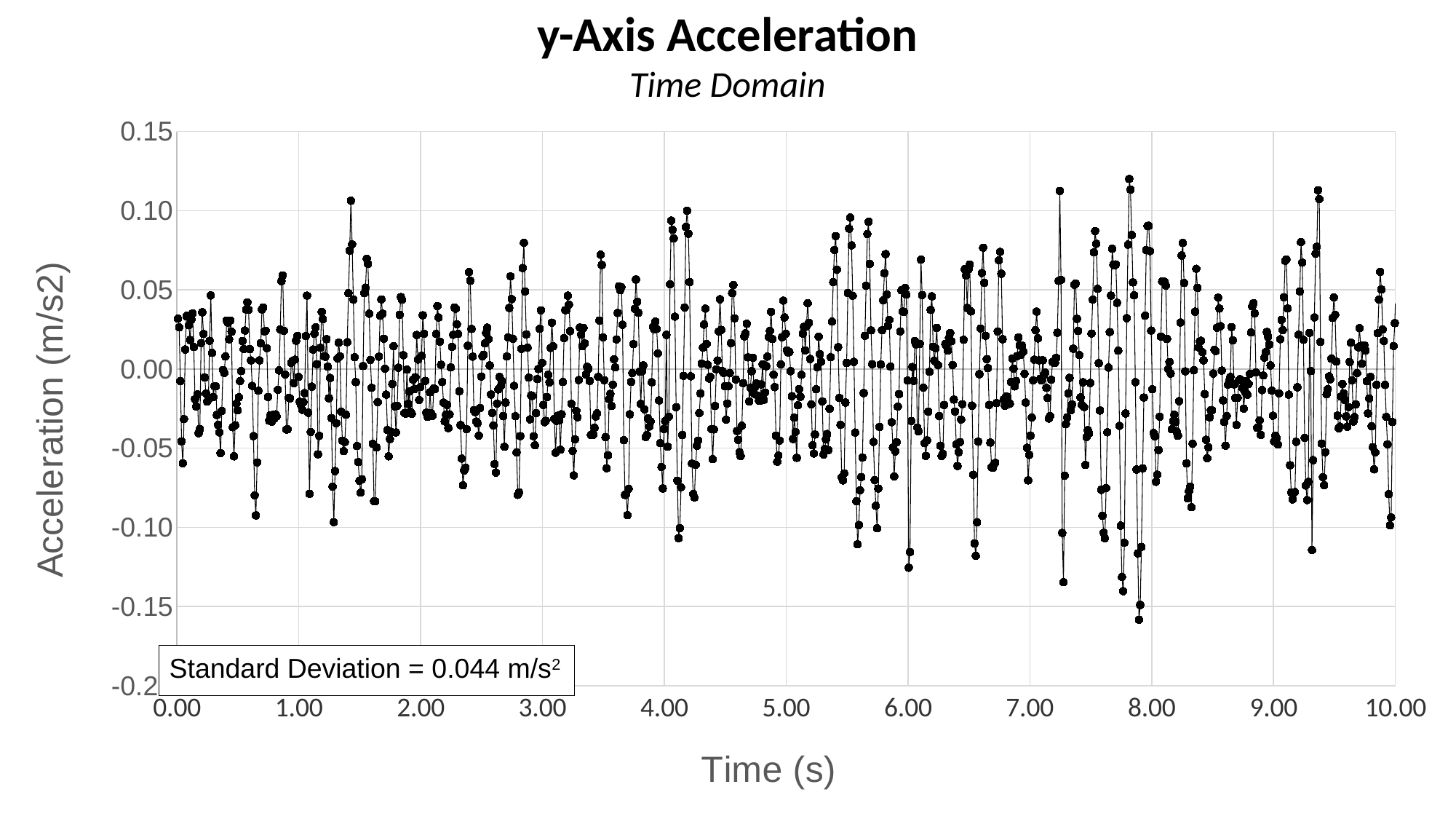
What subtitle appears under the chart title? Time Domain What is the largest time value shown on the x axis? 10.00 Is the lowest acceleration value plotted greater or less than -0.10? less What is the title of the chart? y-Axis Acceleration What is the label of the x axis? Time (s) Does the lowest plotted acceleration value occur before or after 7.00 s? after What is the highest value shown on the y axis? 0.15 What kind of chart is shown on the slide? line chart What standard deviation is stated in the text box on the chart? 0.044 m/s² Is the acceleration value at time 0.00 s greater or less than 0.05? less What is the label of the y axis? Acceleration (m/s2) Is the highest acceleration value plotted greater or less than 0.10? greater